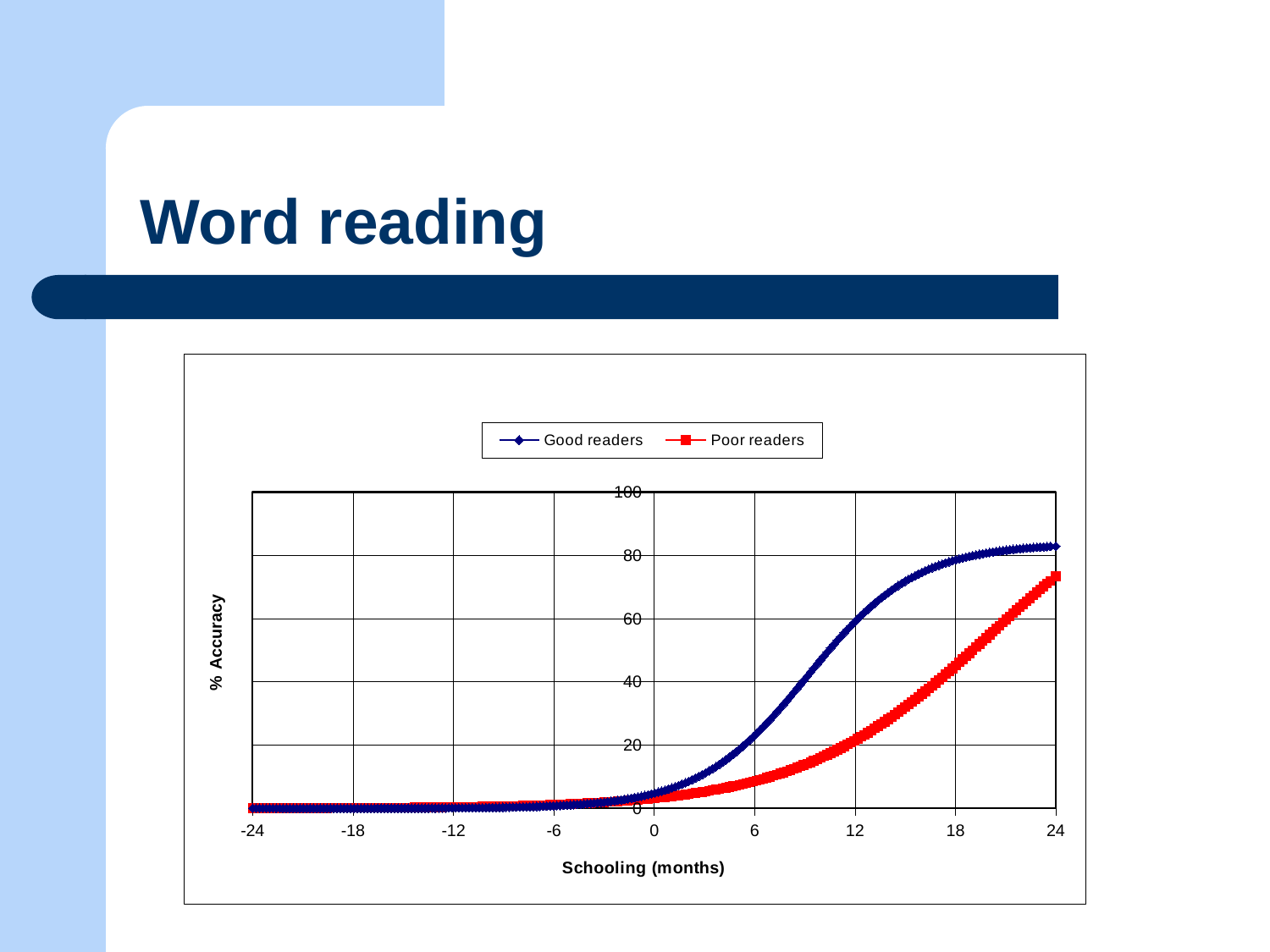
How many series does the legend list? 2 Do the values for Good readers rise or fall as schooling months increase from 0 to 24? rise Is the value for Good readers at 24 months greater or less than 80? greater What are the two series named in the legend? Good readers and Poor readers At 24 months of schooling, which series has the higher % Accuracy, Good readers or Poor readers? Good readers Do the values for Poor readers rise or fall as schooling months increase from 0 to 24? rise What is the label of the y axis? % Accuracy Is the value for Good readers at 0 months greater or less than 20? less Is the value for Poor readers at 18 months greater or less than 60? less What kind of chart is shown on the slide? line chart At 12 months of schooling, which series has the higher % Accuracy, Good readers or Poor readers? Good readers